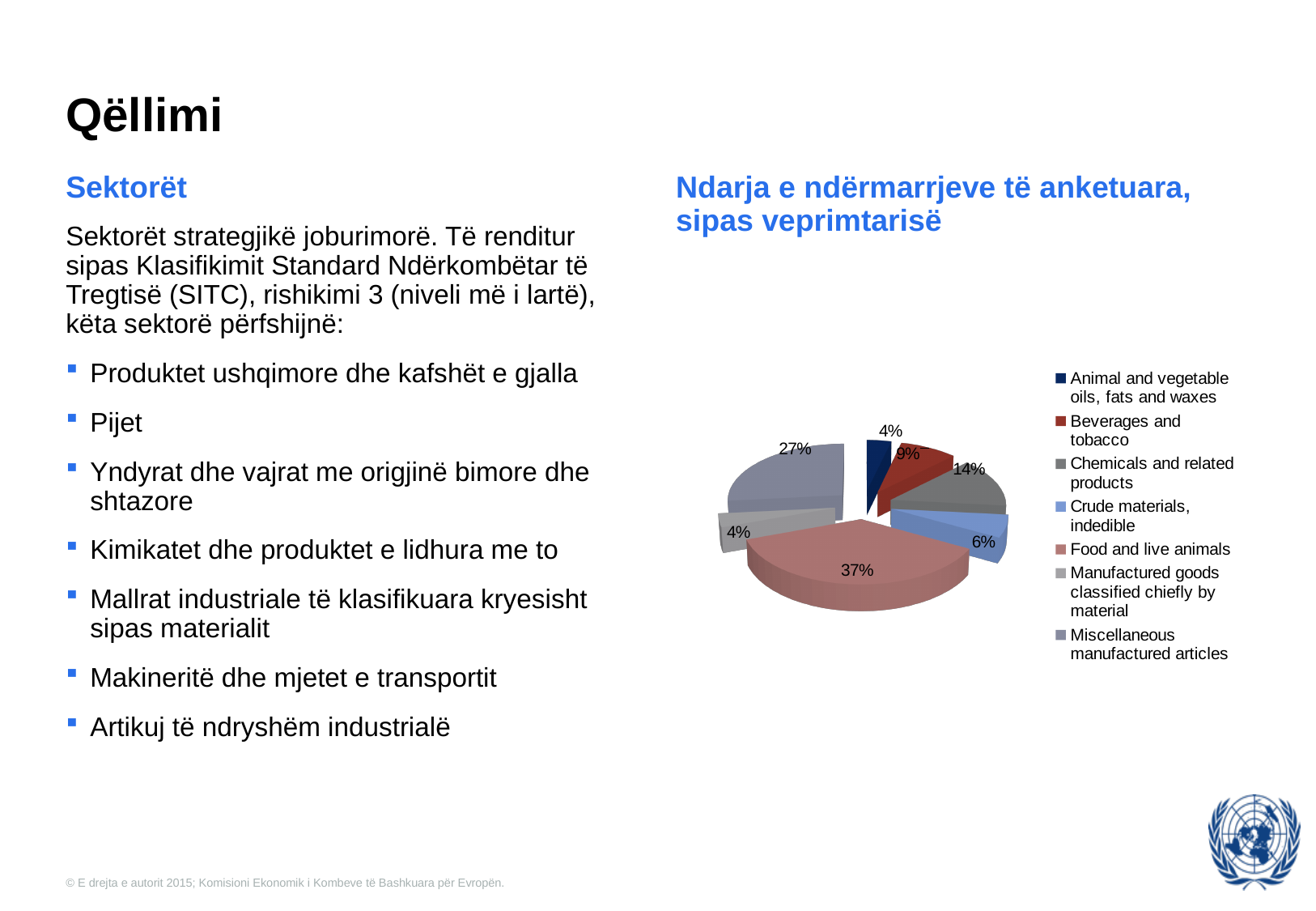
What is the title of the chart on the slide? Ndarja e ndërmarrjeve të anketuara, sipas veprimtarisë Which category has the largest share of the pie? Food and live animals What share of the pie does Chemicals and related products have? 14% What is the difference in percentage points between Food and live animals and Miscellaneous manufactured articles? 10 What share of the pie does Food and live animals have? 37% How many categories does the legend of the pie chart list? 7 What is the difference in percentage points between Chemicals and related products and Crude materials, inedible? 8 What kind of chart is shown on the slide? pie chart What share of the pie does Beverages and tobacco have? 9% Which is larger, the share for Chemicals and related products or the share for Beverages and tobacco? Chemicals and related products